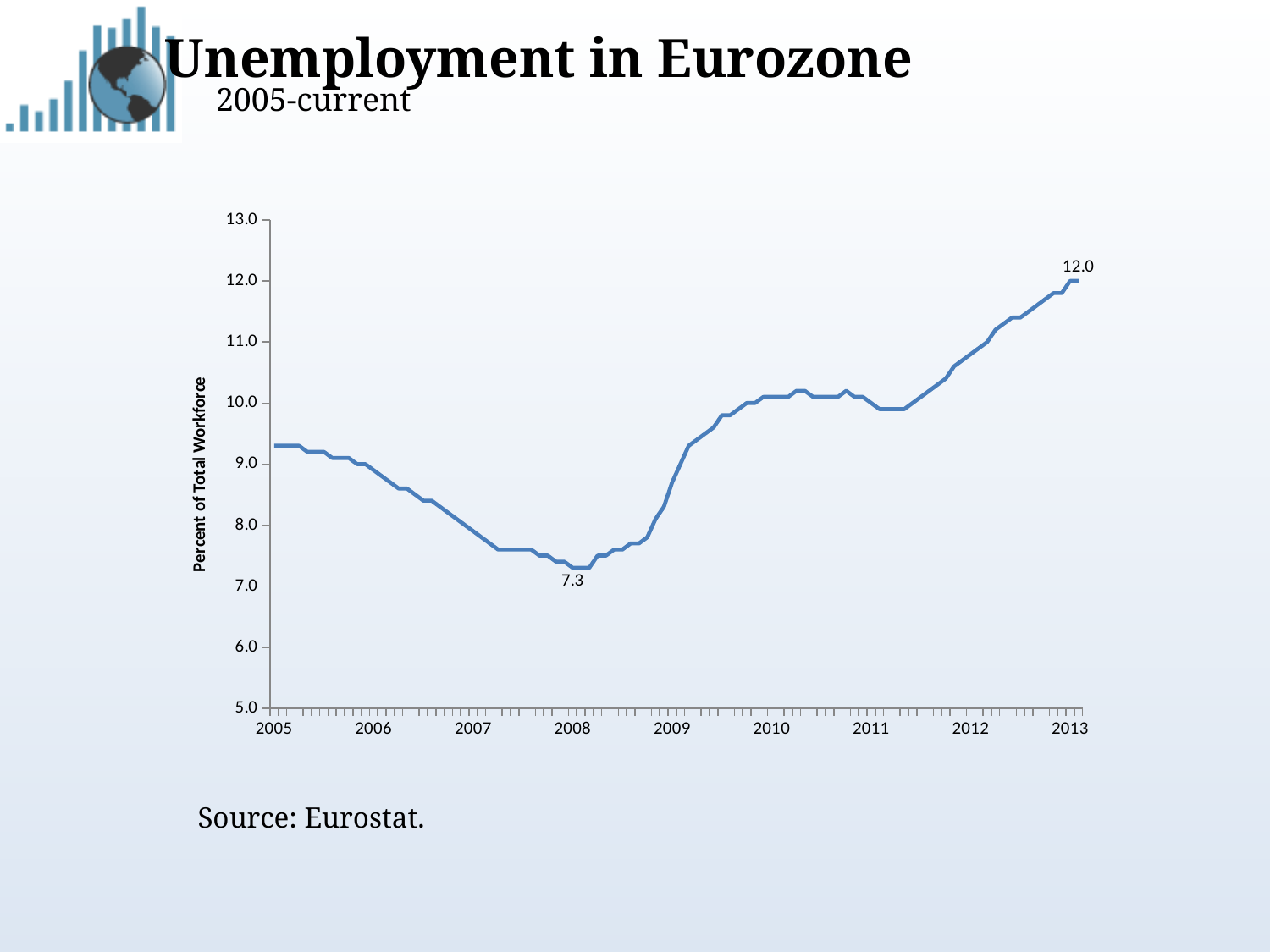
Does the unemployment rate rise or fall between 2011 and 2013? rise What is the unemployment rate at the end of the series in 2013? 12.0 In which year does the line reach its labelled low of 7.3? 2008 What is the label on the vertical axis of the chart? Percent of Total Workforce Is the unemployment rate at the start of 2012 greater or less than 10.0? greater What is the lowest unemployment rate labelled on the chart? 7.3 What is the difference between the labelled peak value of 12.0 and the labelled low of 7.3? 4.7 Does the unemployment rate rise or fall between 2005 and 2008? fall What is the highest unemployment rate labelled on the chart? 12.0 What type of chart is shown on the slide? line chart Is the unemployment rate at the start of 2005 greater or less than 9.0? greater Which is larger, the unemployment rate in 2005 or in 2013? 2013